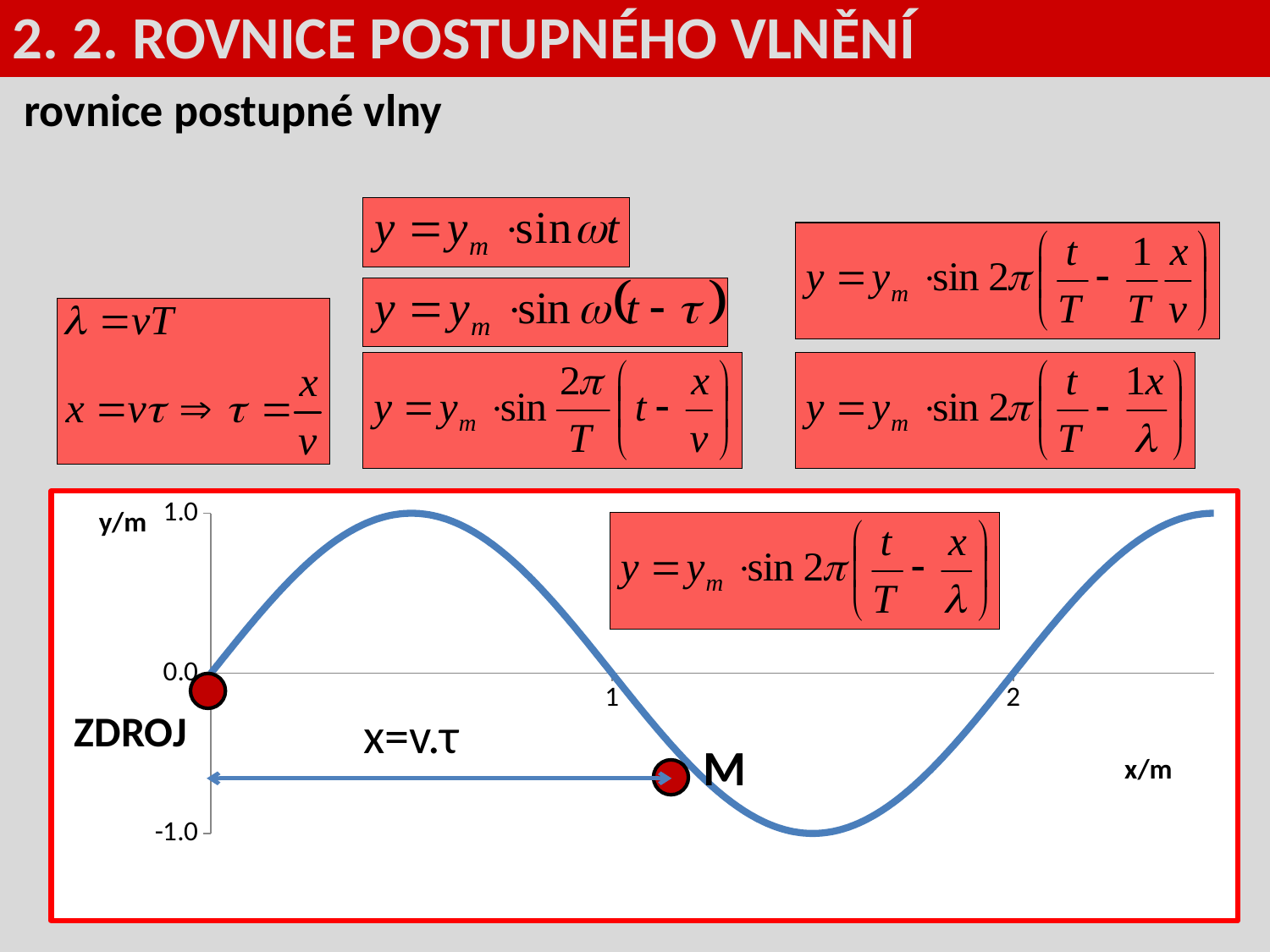
Does the curve rise or fall as x goes from 0.5 to 1.5? fall Which is larger, the value of the curve at x = 0.5 or at x = 1.5? x = 0.5 Is the value of the curve at x = 1.5 greater or less than 0.0? less Is the value of the curve at x = 0.5 greater or less than 0.0? greater What kind of chart is shown at the bottom of the slide? line chart Does the curve rise or fall as x goes from 1.5 to 2.5? rise What is the lowest value shown on the vertical axis of the chart? -1.0 Does the curve rise or fall as x goes from 0 to 0.5? rise How many numbered tick marks are shown on the horizontal axis of the chart? 2 What is the label of the vertical axis of the chart? y/m What is the label of the horizontal axis of the chart? x/m What is the highest value shown on the vertical axis of the chart? 1.0